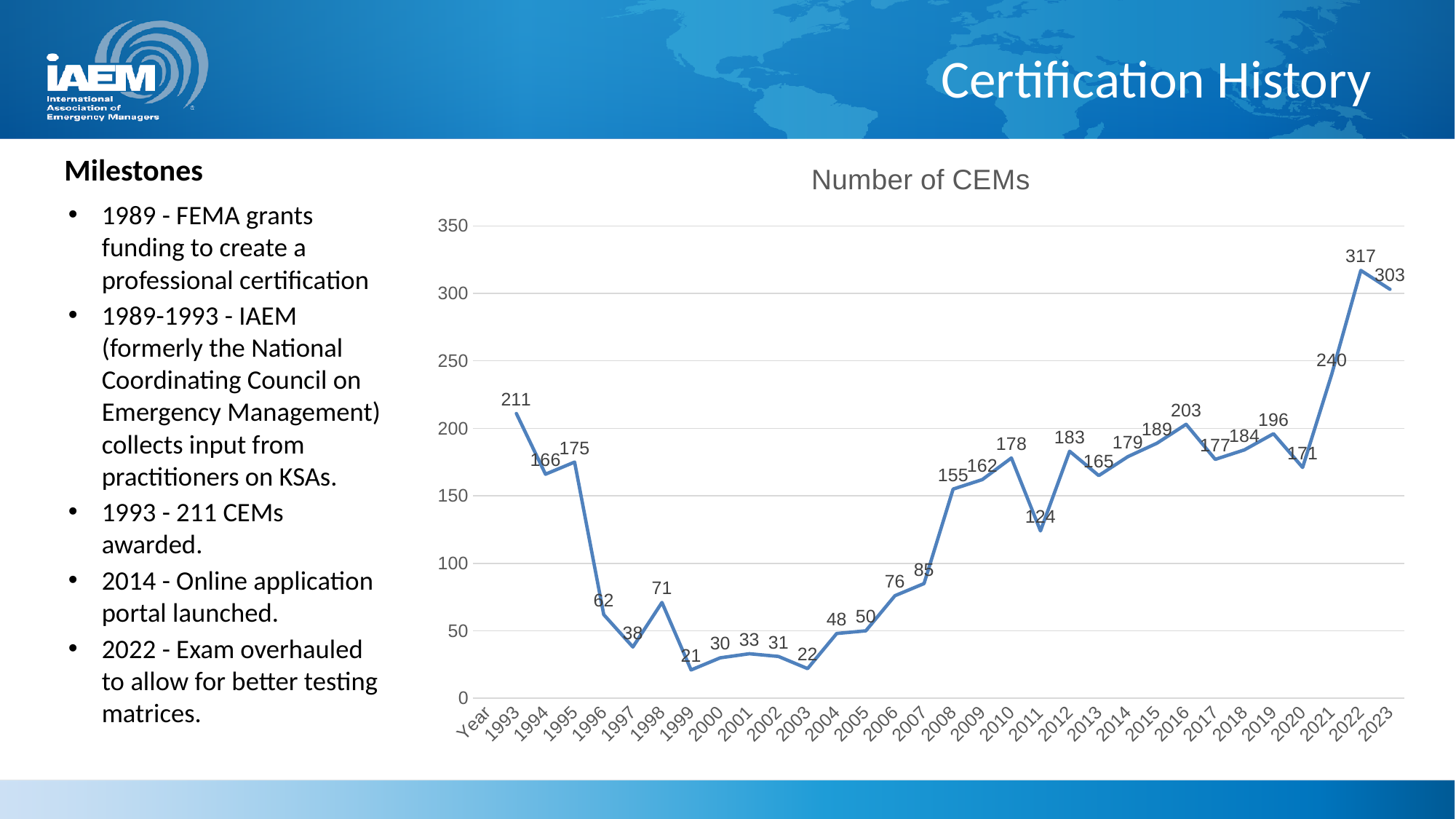
What is the title of the chart? Number of CEMs What is the number of CEMs for 2011? 124 What is the difference between the number of CEMs in 2021 and in 2020? 69 Which year had more CEMs, 2016 or 2019? 2016 Which year has the highest number of CEMs? 2022 What is the difference between the number of CEMs in 2022 and in 2023? 14 Is the value for 2008 greater or less than 150? greater How many CEMs were there in 1993? 211 Does the number of CEMs rise or fall from 1993 to 1999? fall What is the number of CEMs for 2022? 317 What kind of chart is shown on the slide? line chart Which year has the lowest number of CEMs? 1999